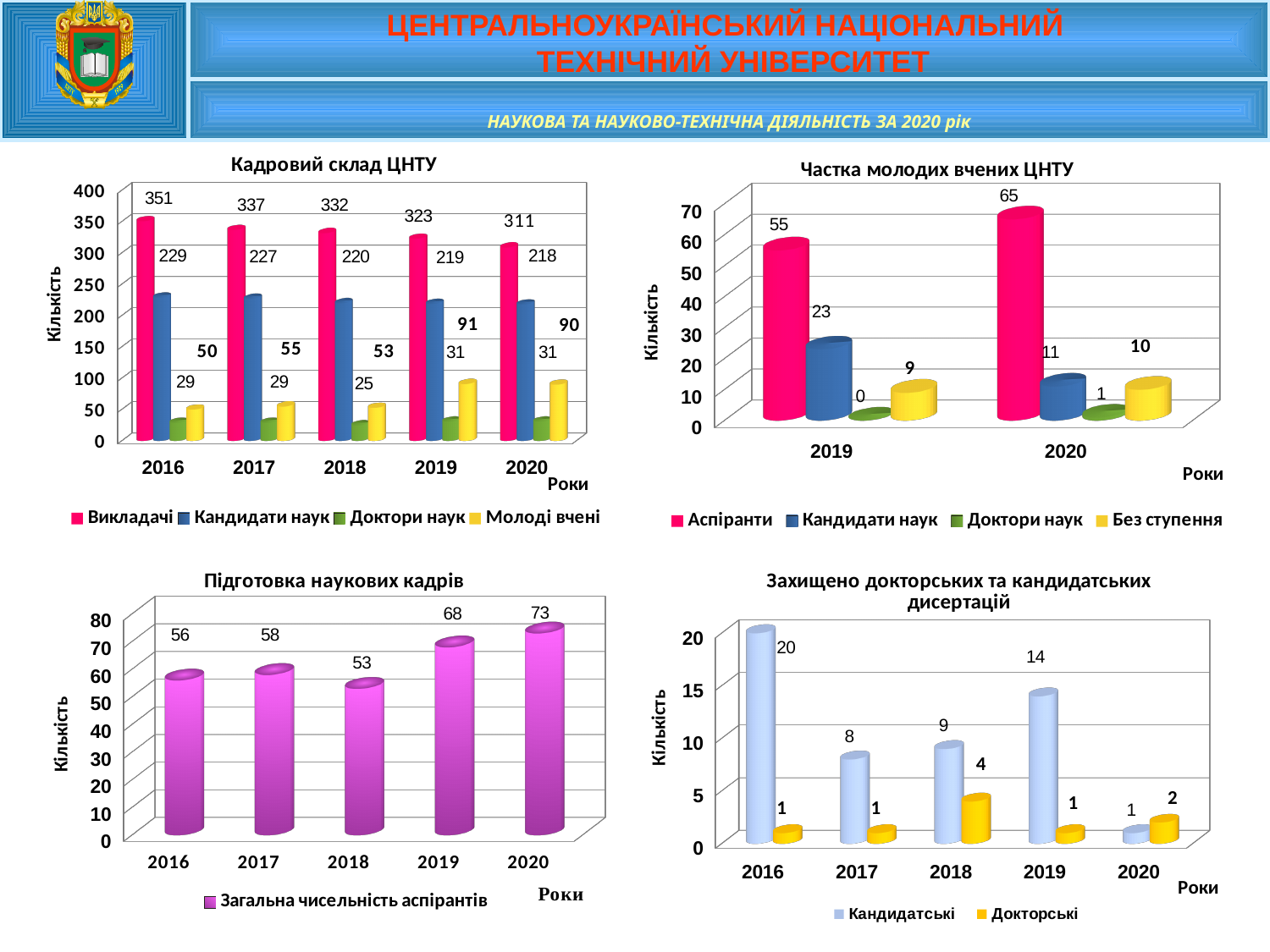
In the chart 'Частка молодих вчених ЦНТУ', what is the value for Аспіранти in 2020? 65 In the chart 'Підготовка наукових кадрів', which year has the highest value? 2020 In the chart 'Кадровий склад ЦНТУ', what is the value for Викладачі in 2016? 351 In the chart 'Захищено докторських та кандидатських дисертацій', in which year is the Докторські value highest? 2018 In the chart 'Підготовка наукових кадрів', what kind of chart is shown? bar chart In the chart 'Частка молодих вчених ЦНТУ', what is the value for Доктори наук in 2019? 0 In the chart 'Частка молодих вчених ЦНТУ', which year has the higher value for Кандидати наук, 2019 or 2020? 2019 In the chart 'Кадровий склад ЦНТУ', how many series does the legend list? 4 In the chart 'Кадровий склад ЦНТУ', what is the value for Молоді вчені in 2019? 91 In the chart 'Кадровий склад ЦНТУ', what is the difference between the Викладачі values for 2016 and 2020? 40 In the chart 'Захищено докторських та кандидатських дисертацій', what is the value for Кандидатські in 2019? 14 In the chart 'Підготовка наукових кадрів', which year has the lowest value? 2018